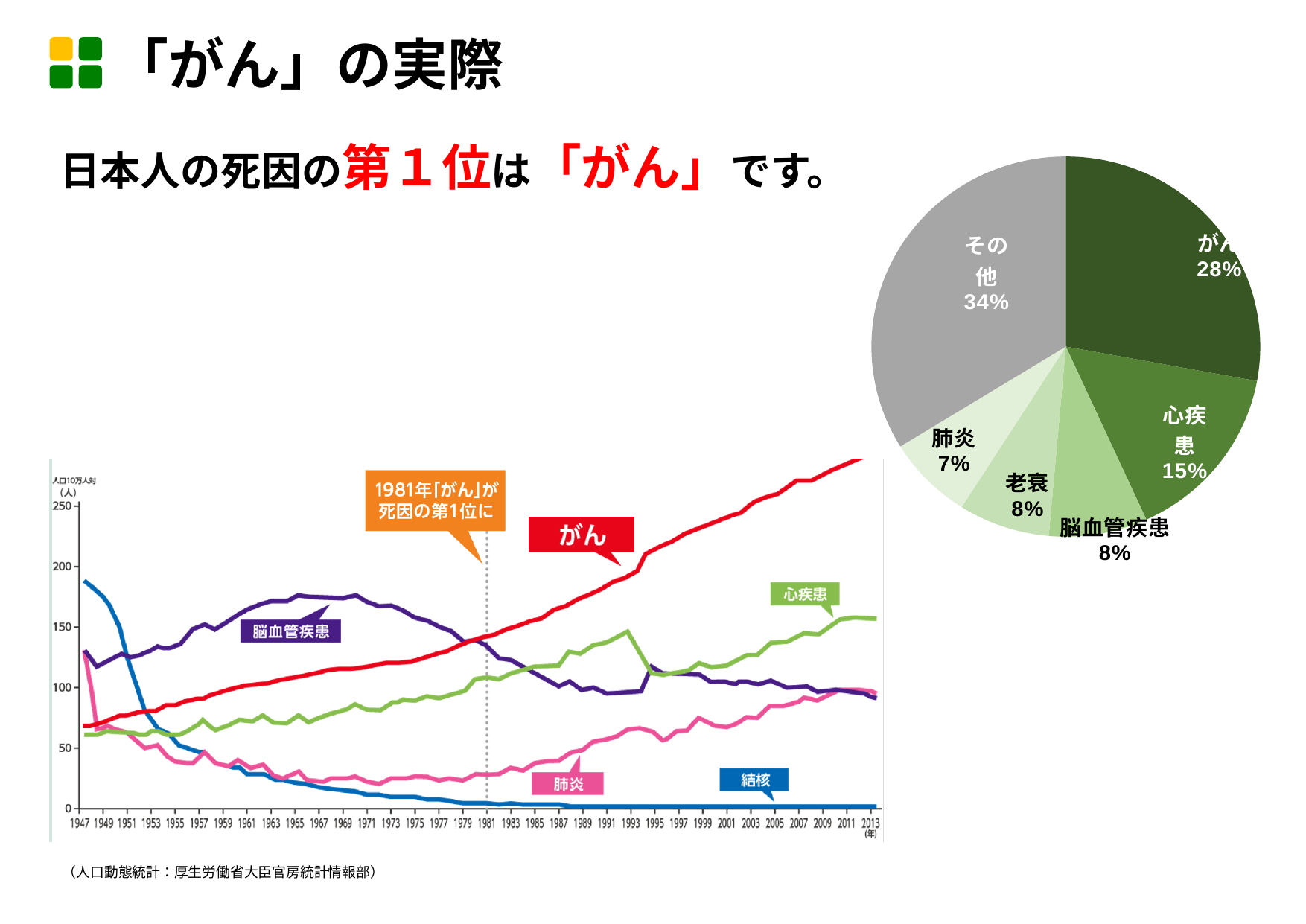
In the pie chart on the right, which slice is the largest? その他 In the pie chart on the right, what share is shown for 心疾患? 15% In the pie chart on the right, what is the difference between the shares of がん and 心疾患? 13% In the pie chart on the right, how many slices are there? 6 In the pie chart on the right, what share is shown for 肺炎? 7% In the pie chart on the right, what share is shown for がん? 28% In the pie chart on the right, which slice is the smallest? 肺炎 What kind of chart is shown at the bottom left of the slide? Line chart In the line chart at the bottom left, is the value for がん in 2013 greater or less than 200? greater In the line chart at the bottom left, does the がん line rise or fall from 1947 to 2013? Rises In the line chart at the bottom left, how many labelled series are plotted? 5 What kind of chart is shown on the right side of the slide? Pie chart